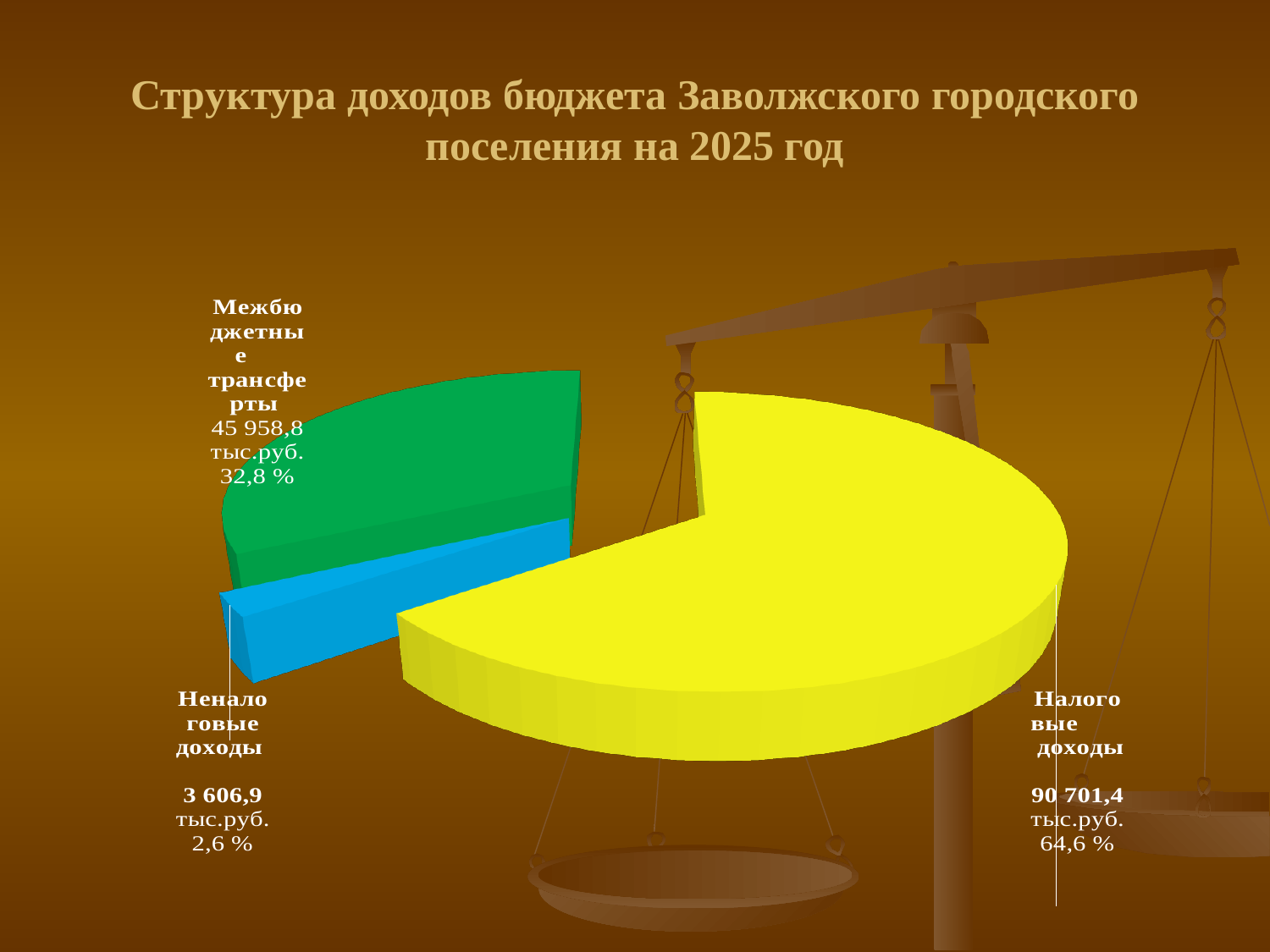
Which category has the largest slice? Налоговые доходы Which category has the smallest slice? Неналоговые доходы What is the value for Налоговые доходы? 90 701,4 тыс.руб. What is the value for Неналоговые доходы? 3 606,9 тыс.руб. What share of the pie does Межбюджетные трансферты take? 32,8 % What is the difference between Налоговые доходы and Межбюджетные трансферты in тыс.руб.? 44 742,6 тыс.руб. What colour is the slice for Налоговые доходы? Yellow How many slices does the pie chart have? 3 What share of the pie does Неналоговые доходы take? 2,6 % What kind of chart is shown on the slide? Pie chart What is the value for Межбюджетные трансферты? 45 958,8 тыс.руб. What share of the pie does Налоговые доходы take? 64,6 %